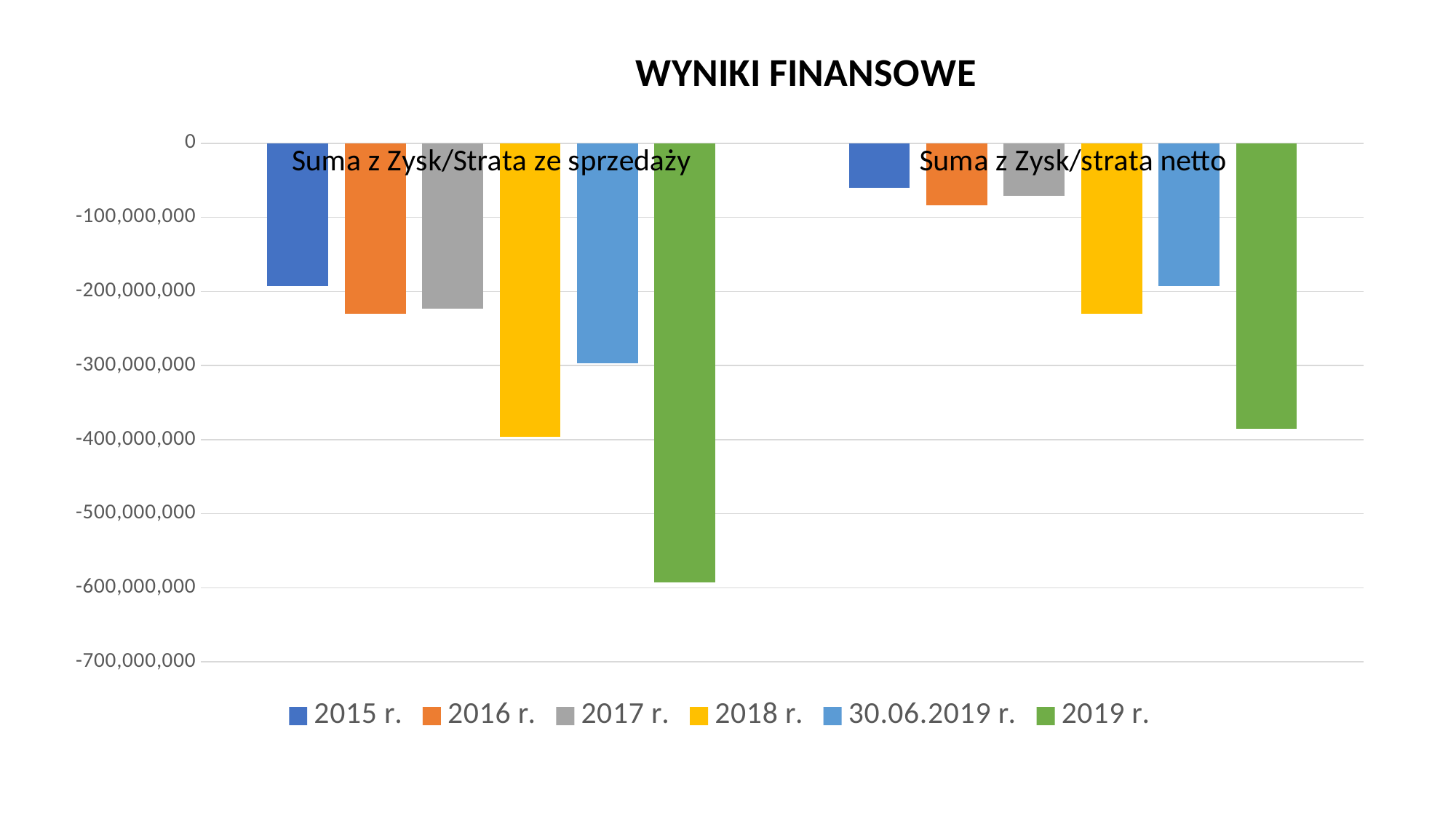
How many categories are shown on the x axis? 2 Which series has the highest (closest to zero) value for Suma z Zysk/strata netto? 2015 r. Is the value for 2015 r. in Suma z Zysk/strata netto greater or less than -100,000,000? greater Which series has the lowest (most negative) value for Suma z Zysk/strata netto? 2019 r. Is the value for 2019 r. in Suma z Zysk/Strata ze sprzedaży greater or less than -500,000,000? less How many series does the legend list? 6 What is the title of the chart? WYNIKI FINANSOWE What kind of chart is shown on the slide? bar chart For Suma z Zysk/Strata ze sprzedaży, which is lower: the value for 2017 r. or the value for 2018 r.? 2018 r. Is the value for 2019 r. in Suma z Zysk/strata netto greater or less than -300,000,000? less Which colour represents the 2018 r. series in the legend? yellow Which series has the lowest (most negative) value for Suma z Zysk/Strata ze sprzedaży? 2019 r.